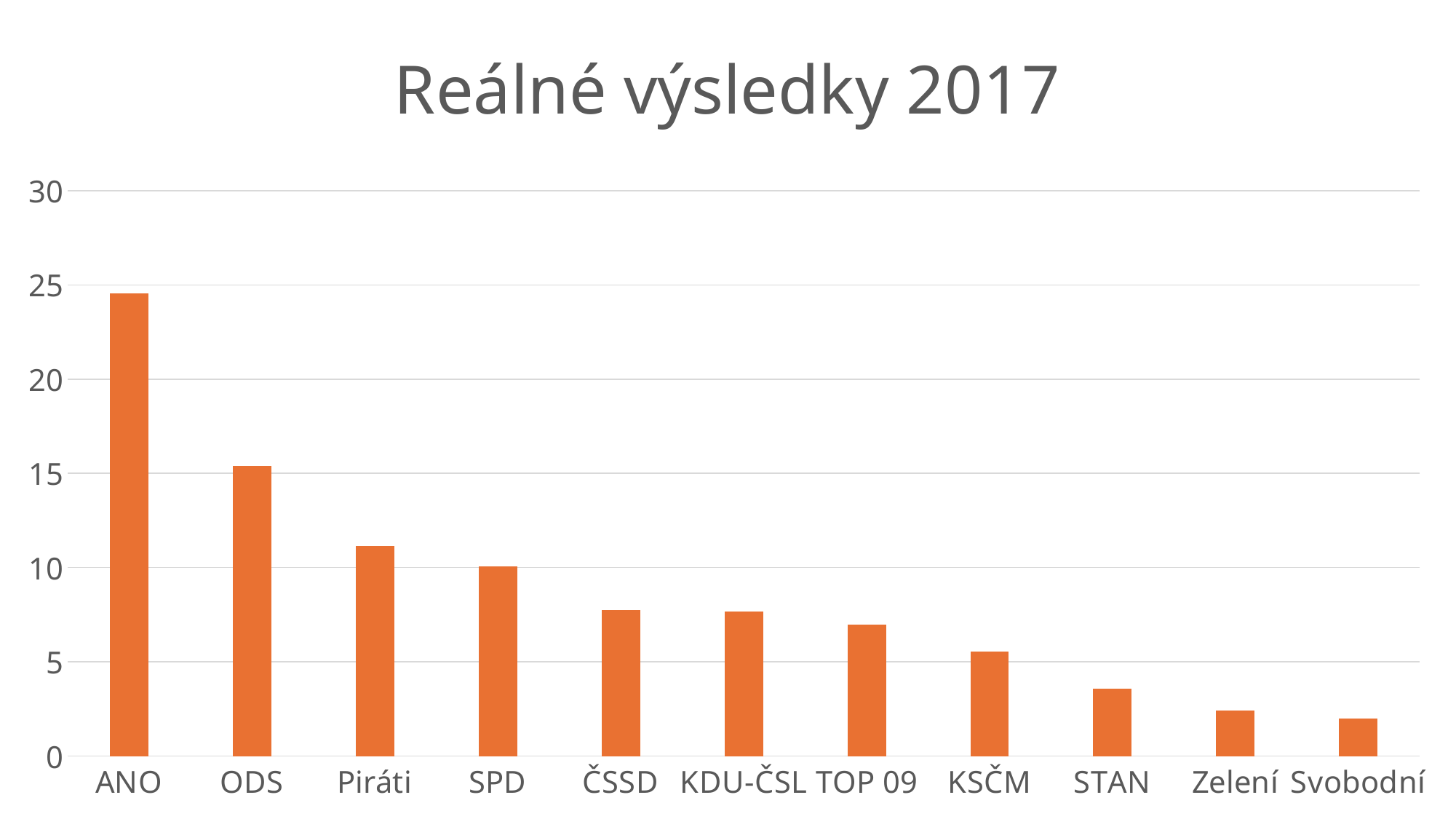
What is the title of the chart? Reálné výsledky 2017 Do the values rise or fall from left to right along the x axis? fall Is the value for ANO greater or less than 20? greater What kind of chart is shown on the slide? bar chart Which category has the lowest value? Svobodní Is the value for KSČM greater or less than 5? greater Which category has the highest value? ANO How many categories (parties) are shown on the x axis? 11 Which is larger, the value for Piráti or the value for TOP 09? Piráti Is the value for STAN greater or less than 5? less